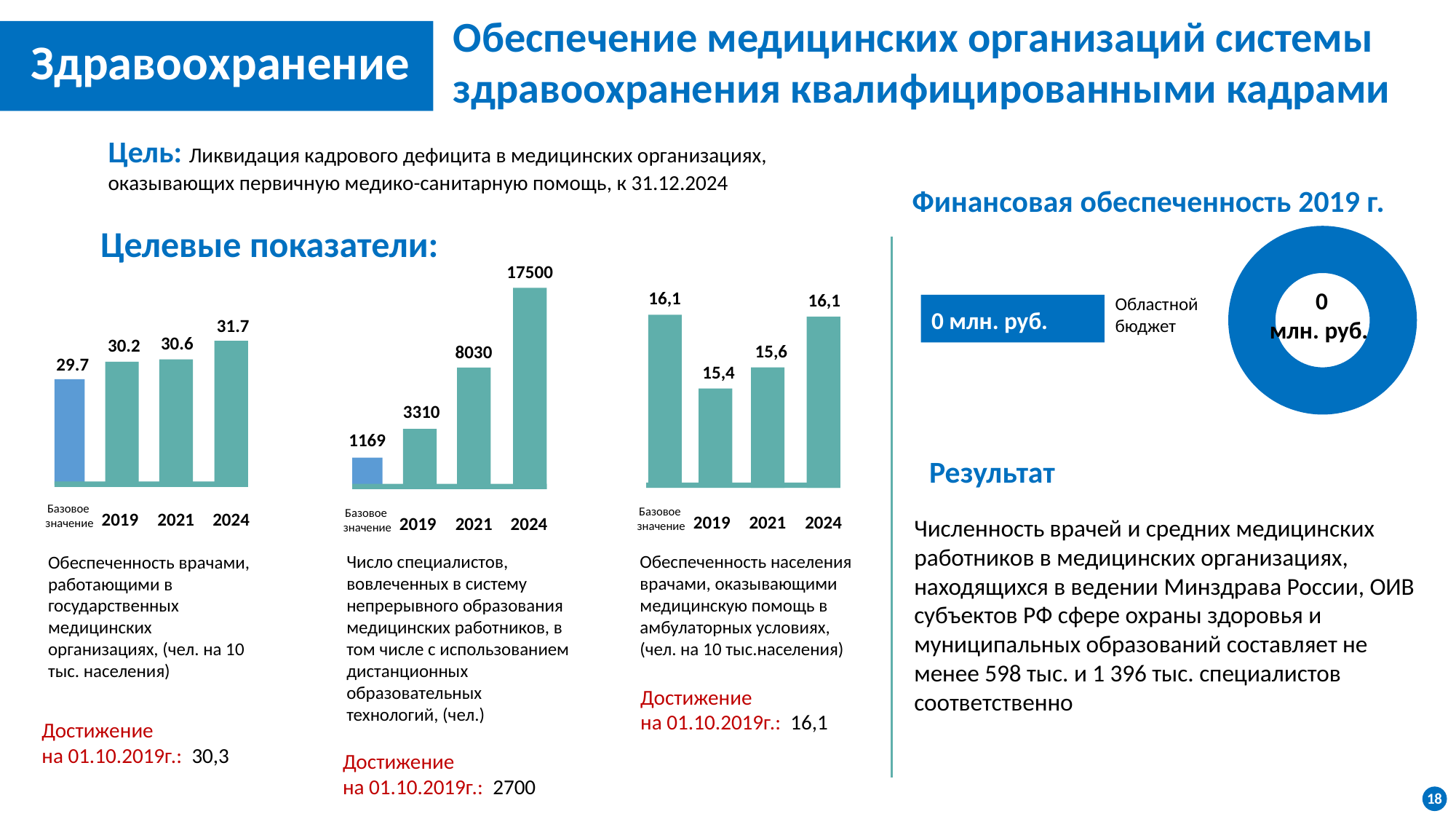
In the middle bar chart (Число специалистов), what is the value for 2021? 8030 How many bars does the left bar chart (Обеспеченность врачами) have? 4 In the middle bar chart (Число специалистов), do the values rise or fall from the base value to 2024? rise In the left bar chart (Обеспеченность врачами), what is the value for 2024? 31.7 What type of chart is used for the three Целевые показатели charts? bar chart In the right bar chart (Обеспеченность населения врачами), which is larger: the value for 2021 or the value for 2024? 2024 In the middle bar chart (Число специалистов), which category has the highest value? 2024 In the right bar chart (Обеспеченность населения врачами), which category has the lowest value? 2019 In the left bar chart (Обеспеченность врачами), what is the difference between the 2024 value and the base value? 2.0 In the left bar chart (Обеспеченность врачами), what is the base value (Базовое значение)? 29.7 In the middle bar chart (Число специалистов), what is the difference between the 2024 and 2019 values? 14190 In the right bar chart (Обеспеченность населения врачами), what is the value for 2019? 15,4